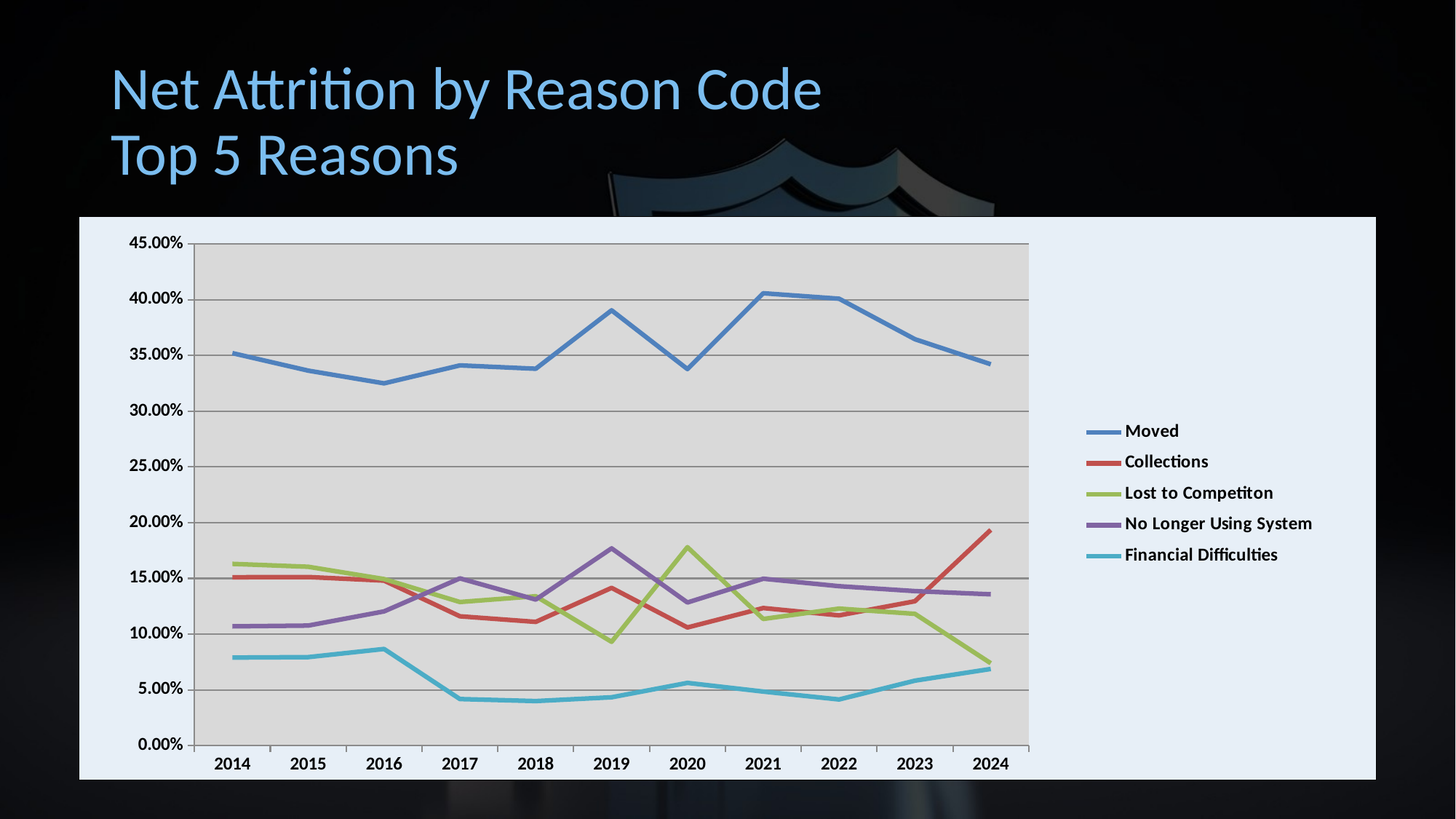
Is the value for Moved in 2019 greater or less than 35.00%? greater Is the value for Collections in 2024 greater or less than 15.00%? greater Is the value for Financial Difficulties in 2017 greater or less than 5.00%? less In 2024, which is larger: Collections or No Longer Using System? Collections What kind of chart is shown on the slide? line chart How many series does the legend list? 5 Which series has the lowest value in 2019? Financial Difficulties Do the values for Collections rise or fall from 2022 to 2024? rise How many years are shown along the x axis? 11 Which series has the highest values across all years? Moved In 2020, which is larger: Lost to Competiton or Collections? Lost to Competiton In which year is the value for Moved at its lowest? 2016